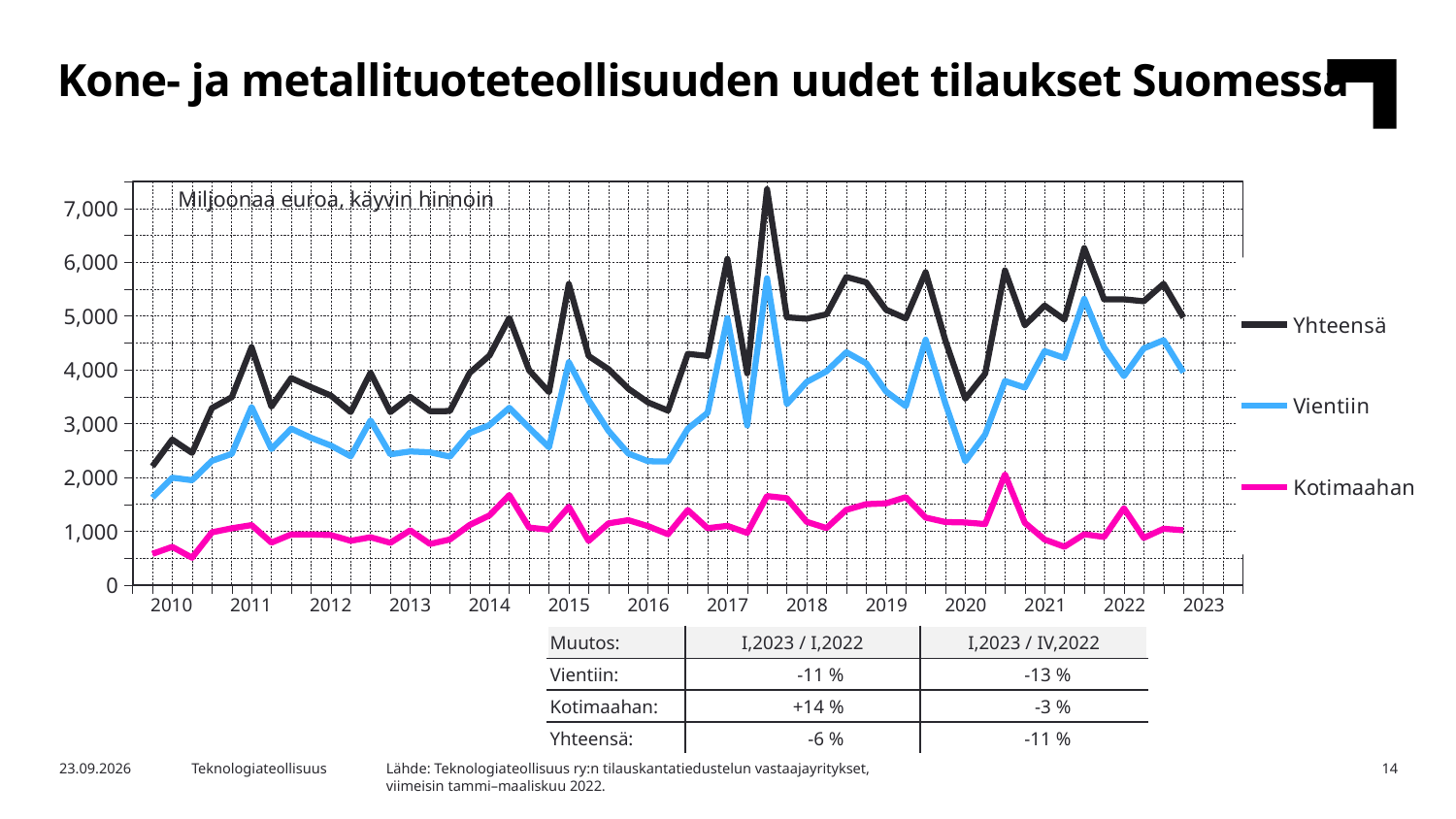
Is the highest peak of the Vientiin line greater or less than 5,000? greater Is the value for Kotimaahan at the start of 2010 greater or less than 1,000? less Which series has the lowest values across the whole chart? Kotimaahan Which series has the highest values across the whole chart? Yhteensä How many year labels are shown on the x axis? 14 How many series does the chart legend list? 3 Is the highest peak of the Yhteensä line greater or less than 7,000? greater Which is larger at the end of the chart in 2023, Vientiin or Kotimaahan? Vientiin In which year does the Yhteensä line reach its highest peak? 2017 What kind of chart is shown on the slide? line chart What unit is stated inside the chart area? Miljoonaa euroa, käyvin hinnoin What are the three series named in the chart legend? Yhteensä, Vientiin, Kotimaahan